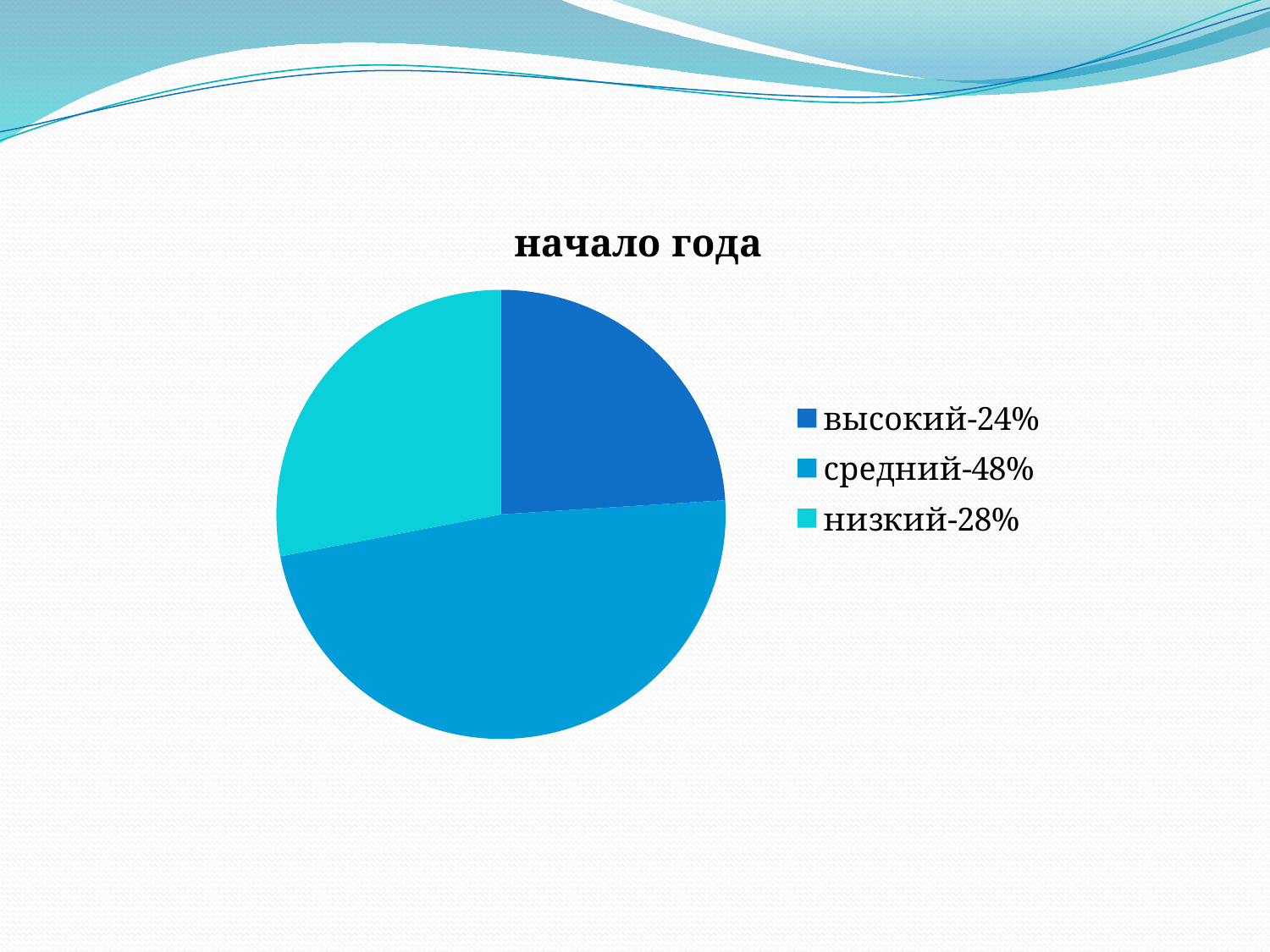
How many slices does the pie chart have? 3 What kind of chart is shown on the slide? pie chart What share of the pie does the 'высокий' slice represent? 24% Which category has the largest slice of the pie? средний Which category has the smallest slice of the pie? высокий What share of the pie does the 'низкий' slice represent? 28% Which legend entry is shown in the lightest (turquoise) colour? низкий-28% What is the title of the chart? начало года What is the difference in percentage points between the 'средний' and 'высокий' slices? 24 What share of the pie does the 'средний' slice represent? 48% Which is larger, the 'низкий' slice or the 'высокий' slice? низкий What is the difference in percentage points between the 'низкий' and 'высокий' slices? 4